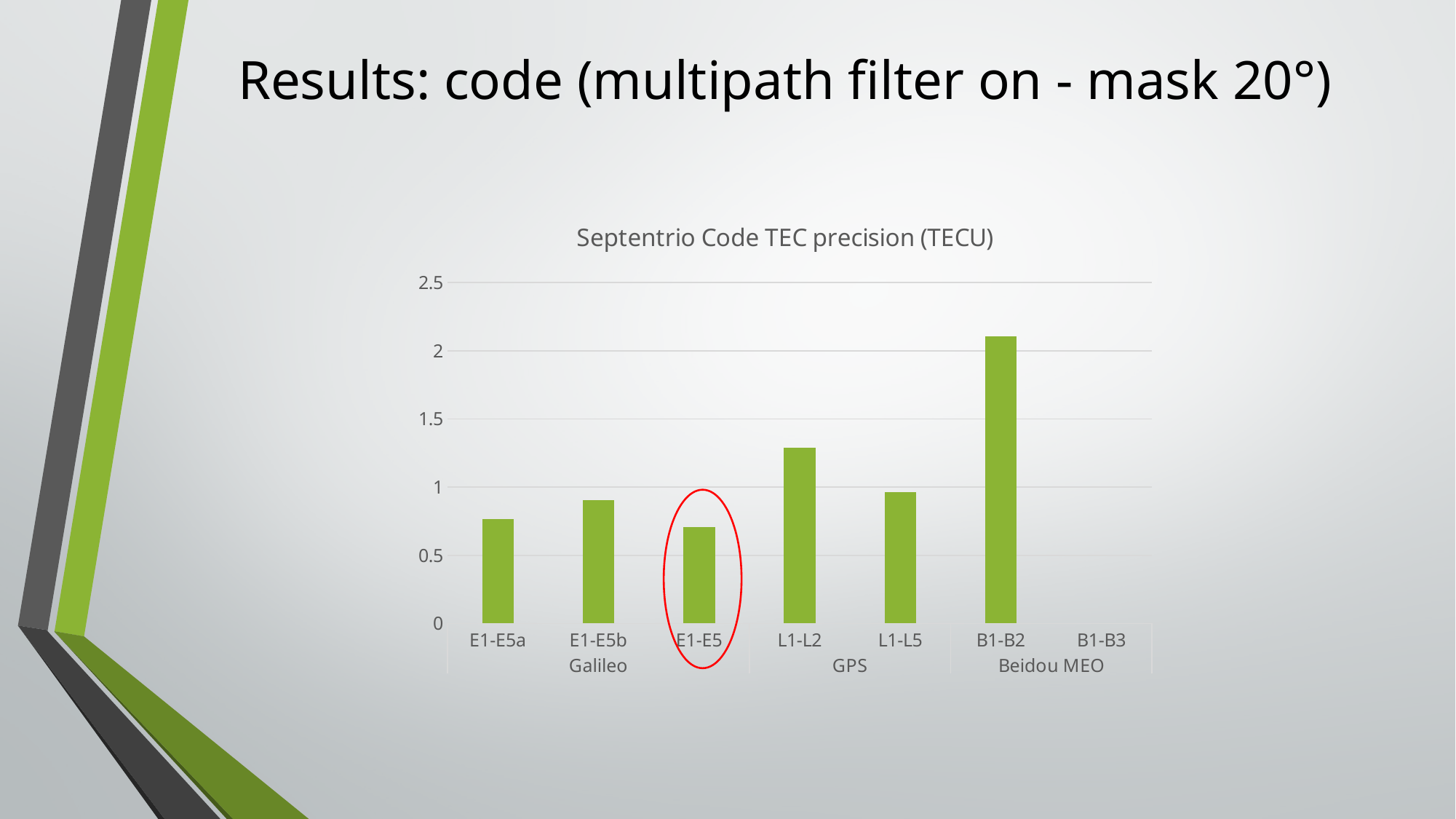
Which category label has no visible bar in the chart? B1-B3 What is the title of the chart? Septentrio Code TEC precision (TECU) What kind of chart is shown on the slide? bar chart Is the value for E1-E5 greater or less than 1? less Is the value for B1-B2 greater or less than 2? greater Is the value for E1-E5a greater or less than 0.5? greater Which has the larger value, L1-L2 or L1-L5? L1-L2 Which category's bar is circled in red on the chart? E1-E5 How many category labels are shown along the x axis of the chart? 7 Which has the larger value, E1-E5b or E1-E5? E1-E5b Which category has the highest bar in the chart? B1-B2